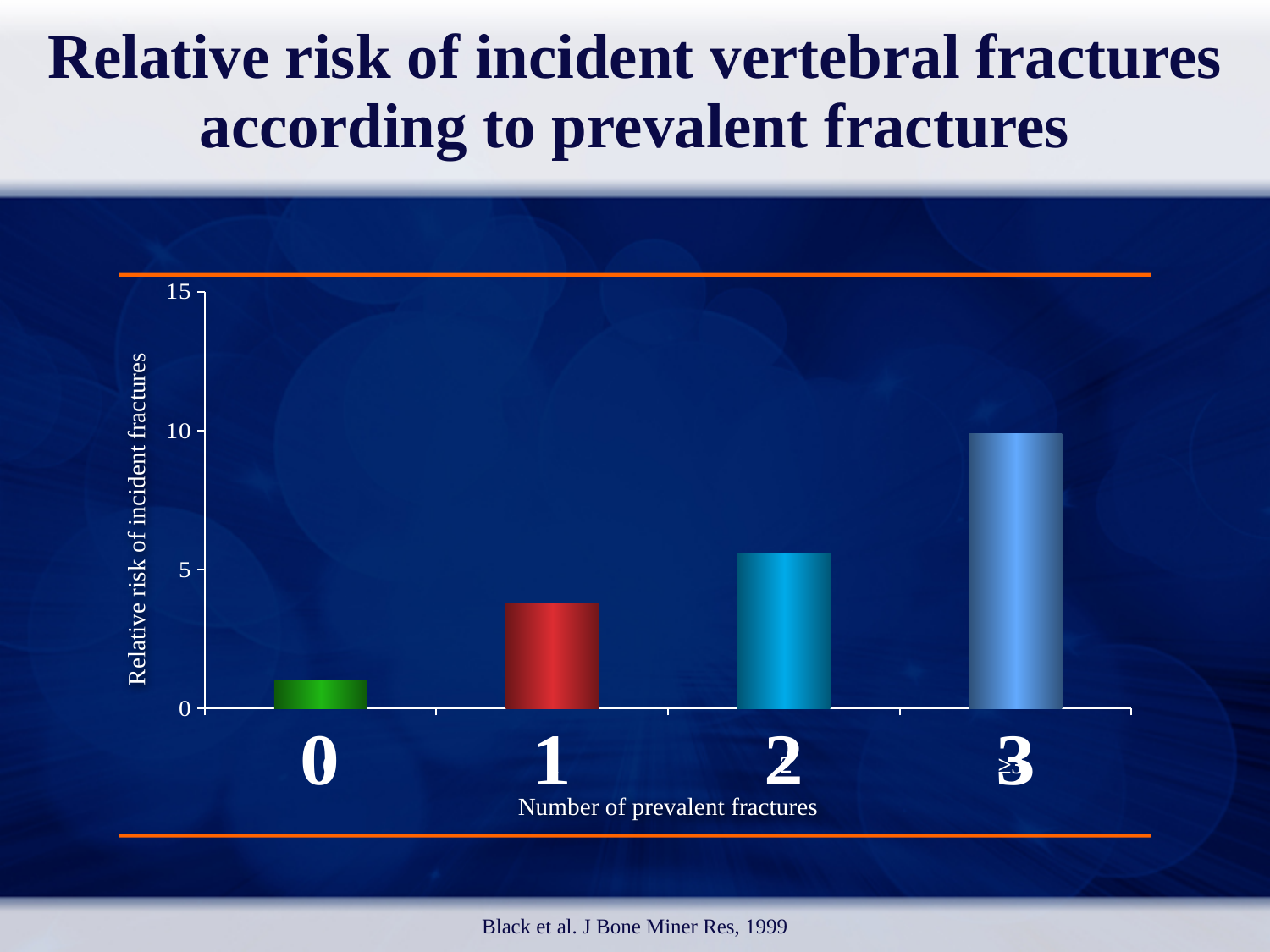
Which number of prevalent fractures has the lowest relative risk of incident fractures? 0 Is the relative risk for 1 prevalent fracture greater or less than 5? less What colour is the bar for 0 prevalent fractures? green What kind of chart is shown on the slide? bar chart What is the label of the y axis? Relative risk of incident fractures Which has a larger relative risk of incident fractures: 1 prevalent fracture or 2 prevalent fractures? 2 prevalent fractures How many categories of prevalent fractures are plotted on the x axis? 4 Is the relative risk for 3 prevalent fractures greater or less than 5? greater Which number of prevalent fractures has the highest relative risk of incident fractures? 3 Is the relative risk for 2 prevalent fractures greater or less than 5? greater Does the relative risk of incident fractures rise or fall as the number of prevalent fractures increases? rise